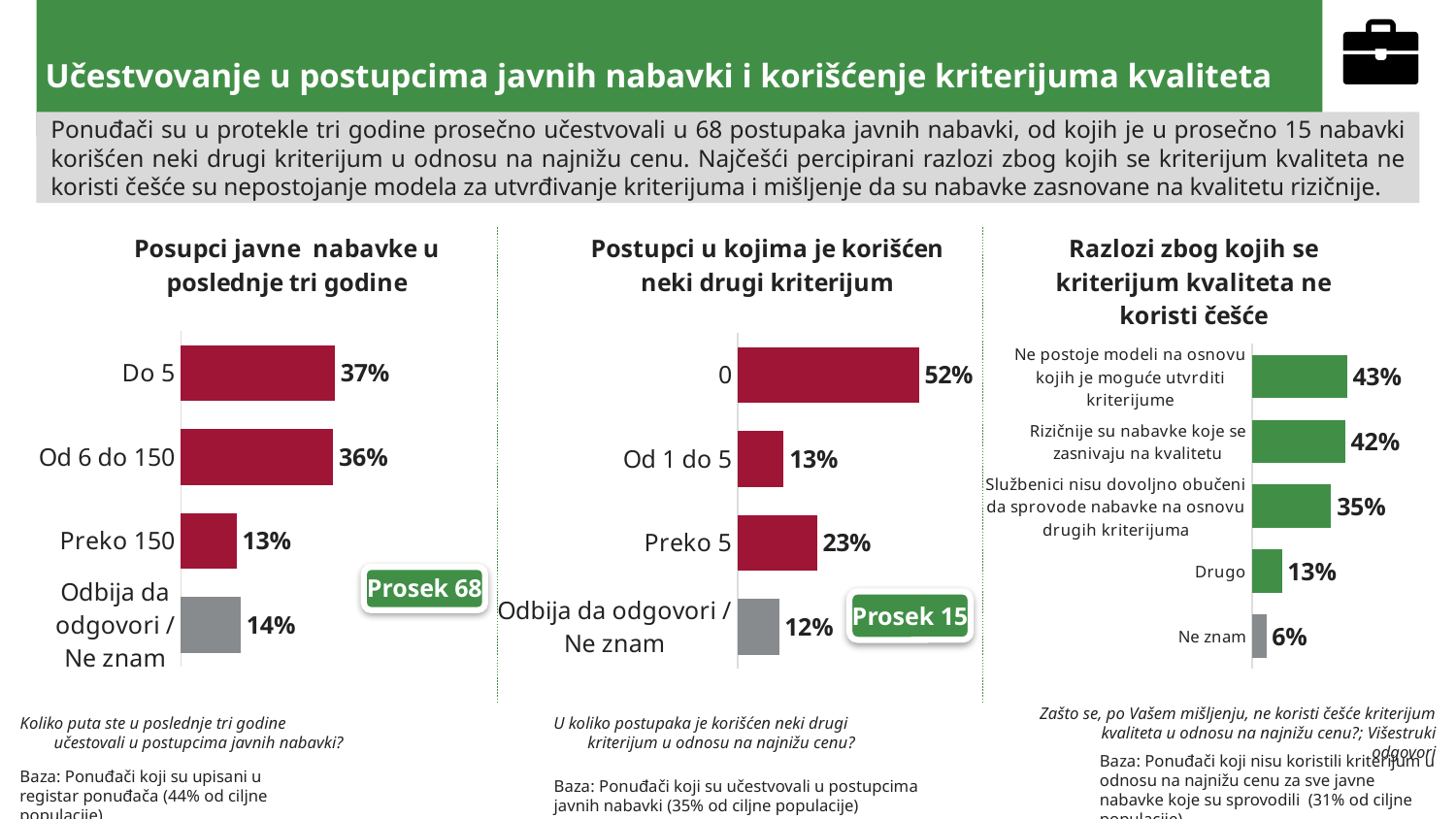
In the chart 'Posupci javne nabavke u poslednje tri godine', what is the difference between 'Do 5' and 'Od 6 do 150'? 1% What type of chart is 'Posupci javne nabavke u poslednje tri godine'? Bar chart In the chart 'Razlozi zbog kojih se kriterijum kvaliteta ne koristi češće', what is the difference between 'Ne postoje modeli na osnovu kojih je moguće utvrditi kriterijume' and 'Službenici nisu dovoljno obučeni da sprovode nabavke na osnovu drugih kriterijuma'? 8% In the chart 'Postupci u kojima je korišćen neki drugi kriterijum', which category has the lowest value? Odbija da odgovori / Ne znam In the chart 'Razlozi zbog kojih se kriterijum kvaliteta ne koristi češće', what is the value for 'Drugo'? 13% In the chart 'Postupci u kojima je korišćen neki drugi kriterijum', which category has the highest value? 0 In the chart 'Postupci u kojima je korišćen neki drugi kriterijum', what is the value for 'Preko 5'? 23% In the chart 'Razlozi zbog kojih se kriterijum kvaliteta ne koristi češće', which category has the lowest value? Ne znam In the chart 'Postupci u kojima je korišćen neki drugi kriterijum', how many categories are shown? 4 In the chart 'Posupci javne nabavke u poslednje tri godine', what is the value for 'Do 5'? 37% In the chart 'Razlozi zbog kojih se kriterijum kvaliteta ne koristi češće', how many categories are shown? 5 In the chart 'Posupci javne nabavke u poslednje tri godine', what is the value for 'Preko 150'? 13%